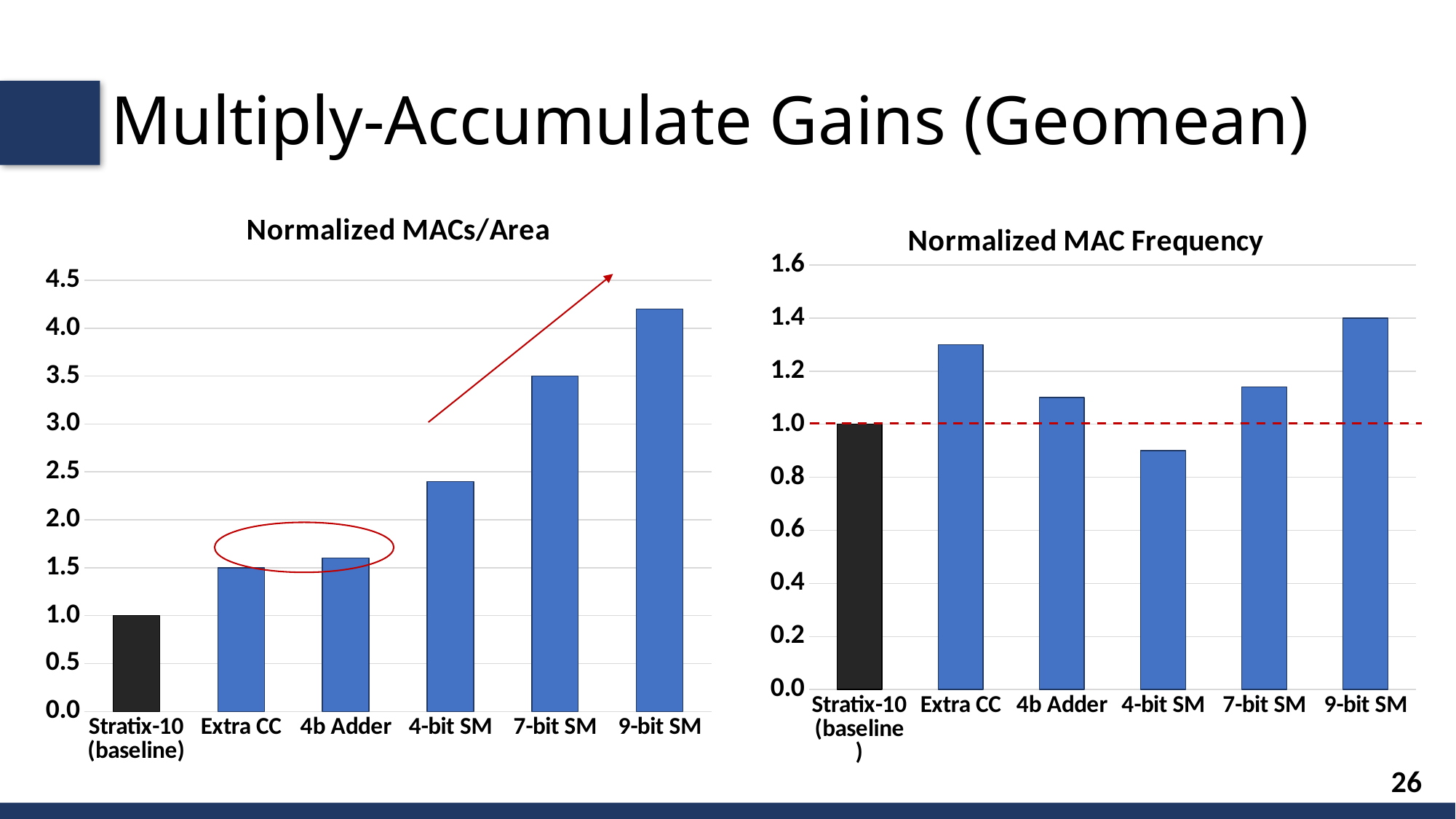
In the Normalized MACs/Area chart, which category has the highest value? 9-bit SM In the Normalized MACs/Area chart, which category has the lowest value? Stratix-10 (baseline) In the Normalized MACs/Area chart, is the value for 9-bit SM greater or less than 4.0? greater In the Normalized MAC Frequency chart, which category has the highest value? 9-bit SM In the Normalized MAC Frequency chart, is the value for 4-bit SM greater or less than 1.0? less In the Normalized MAC Frequency chart, which is larger, the value for Extra CC or the value for 4b Adder? Extra CC How many categories are shown in the Normalized MAC Frequency chart? 6 In the Normalized MAC Frequency chart, which category has the lowest value? 4-bit SM Do the values in the Normalized MACs/Area chart generally rise or fall from left to right? rise What kind of chart is the Normalized MACs/Area chart? bar chart In the Normalized MACs/Area chart, what is the value for 7-bit SM? 3.5 In the Normalized MACs/Area chart, what is the value for Stratix-10 (baseline)? 1.0